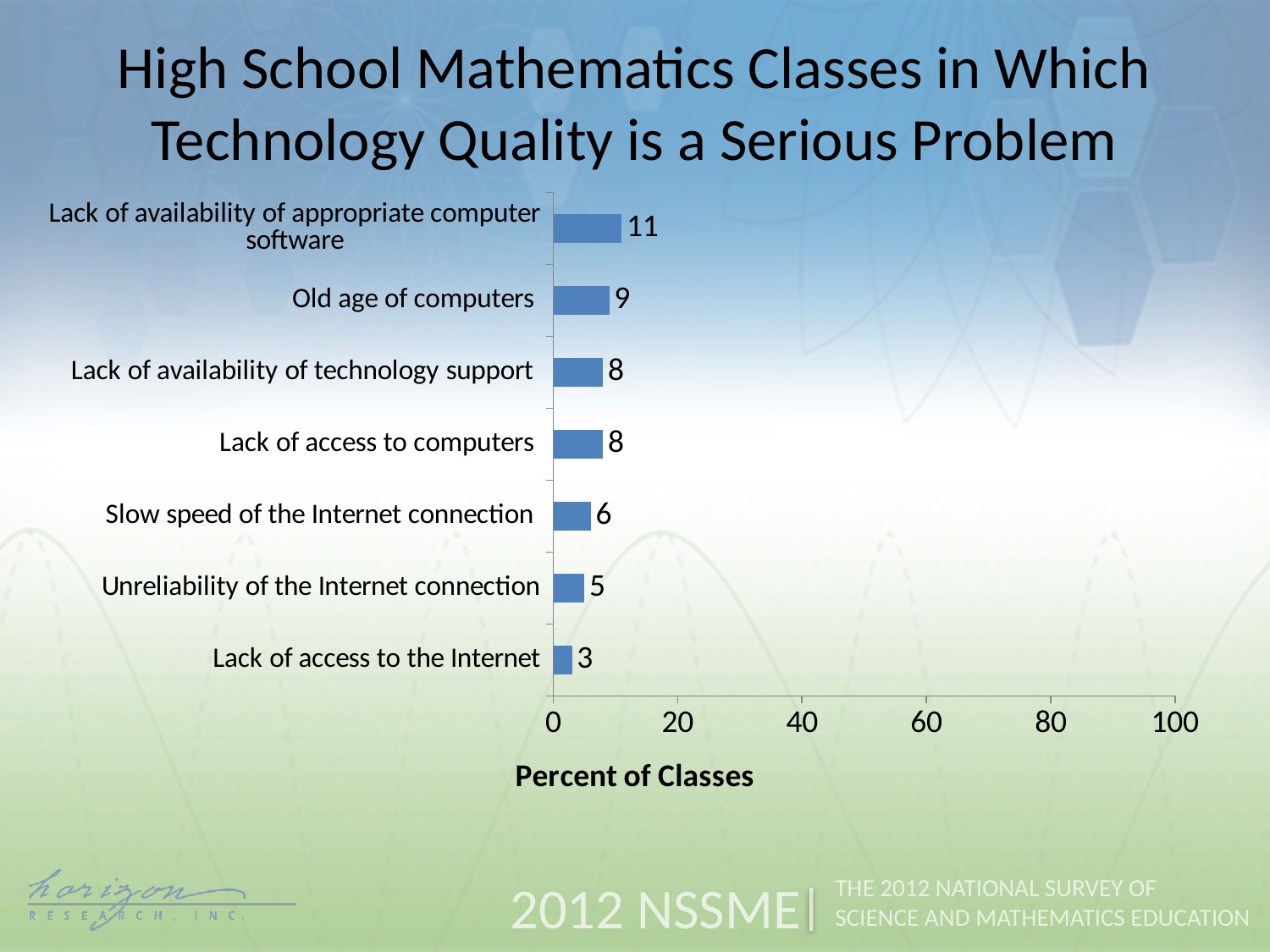
Which category has the lowest value? Lack of access to the Internet What percent of classes report lack of availability of appropriate computer software as a serious problem? 11 Which is larger, the value for Lack of access to computers or the value for Slow speed of the Internet connection? Lack of access to computers What is the label of the horizontal axis? Percent of Classes What is the value for Old age of computers? 9 What is the value for Lack of access to the Internet? 3 Is the value for Lack of availability of appropriate computer software greater or less than 20? less What is the difference between the values for Old age of computers and Unreliability of the Internet connection? 4 What kind of chart is shown on the slide? Bar chart What is the value for Slow speed of the Internet connection? 6 Which category has the highest value? Lack of availability of appropriate computer software How many categories are shown in the chart? 7